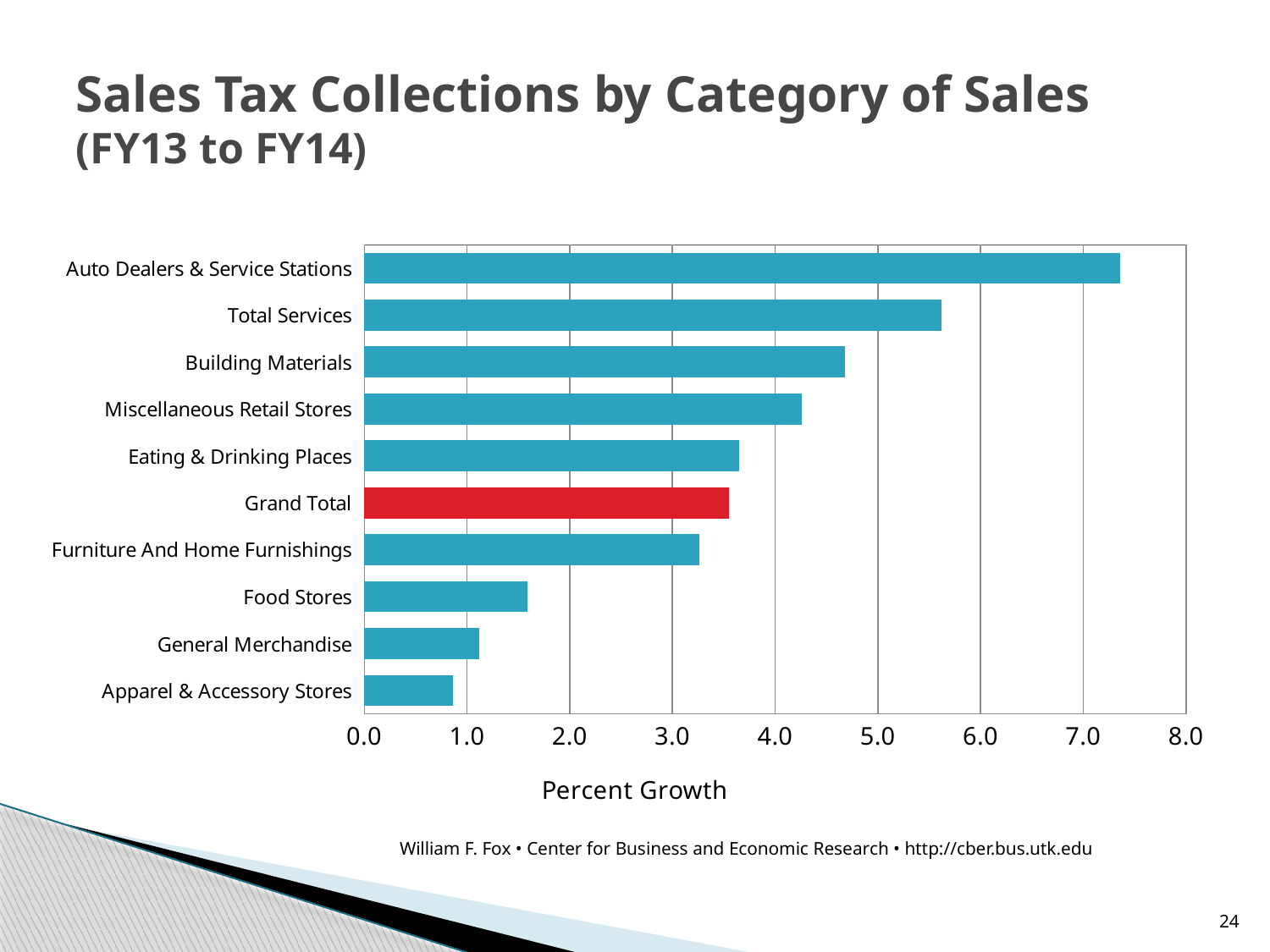
Which has higher percent growth, Building Materials or Miscellaneous Retail Stores? Building Materials Which category has the highest percent growth? Auto Dealers & Service Stations Is the percent growth for Food Stores greater or less than 2.0? less What kind of chart is shown on the slide? bar chart Is the percent growth for Apparel & Accessory Stores greater or less than 1.0? less Is the percent growth for Total Services greater or less than 5.0? greater Which category's bar is shown in red rather than blue? Grand Total How many categories are plotted in the chart? 10 Which has higher percent growth, Furniture And Home Furnishings or General Merchandise? Furniture And Home Furnishings Which category has the lowest percent growth? Apparel & Accessory Stores What is the label of the horizontal axis? Percent Growth